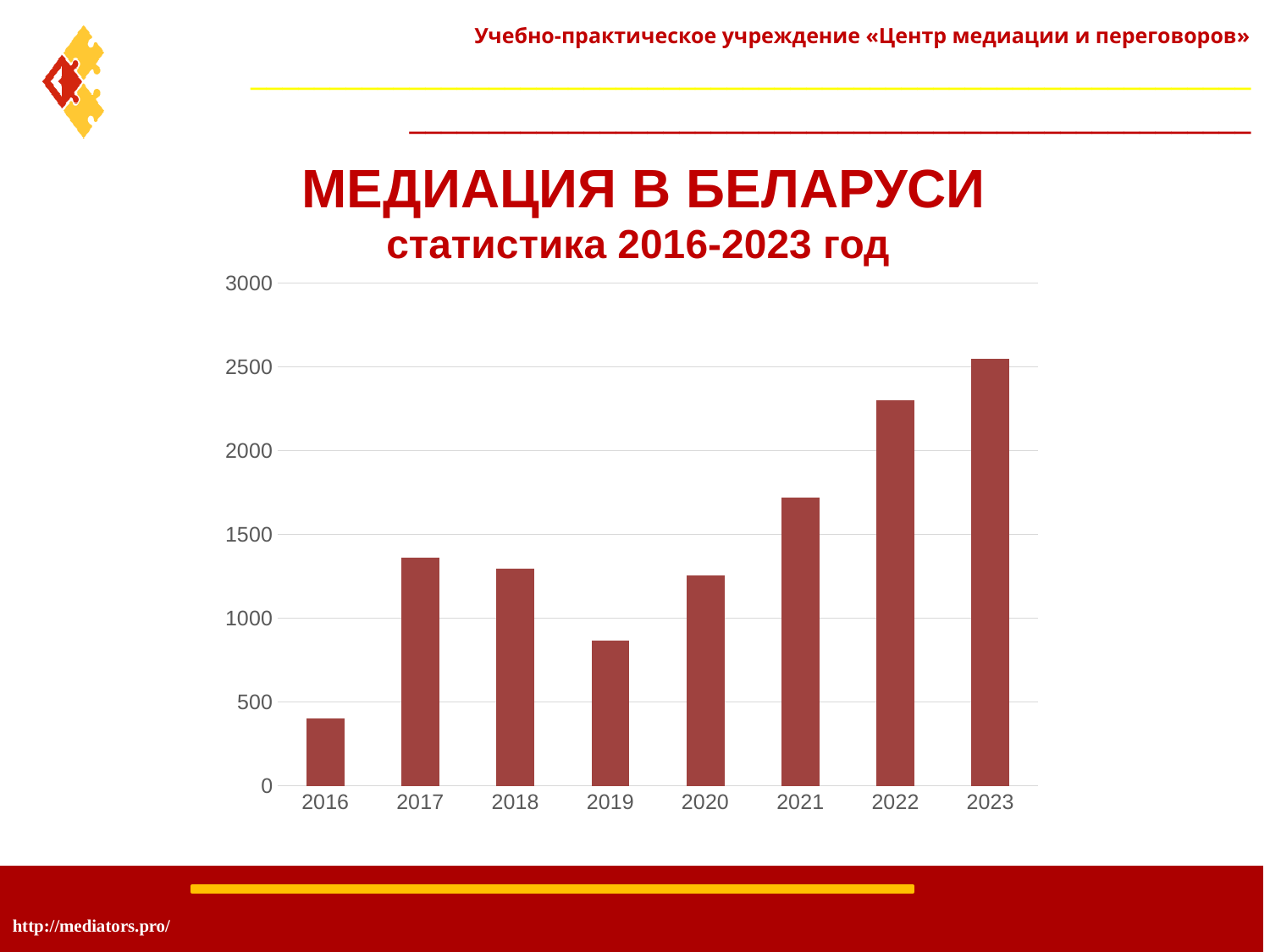
Is the value for 2022 greater or less than 2000? greater What kind of chart is shown on the slide? bar chart Which year has the highest bar in the chart? 2023 Which year has the larger value, 2019 or 2021? 2021 What is the subtitle of the chart below «МЕДИАЦИЯ В БЕЛАРУСИ»? статистика 2016-2023 год How many years are shown on the x axis of the chart? 8 Which year has the lowest bar in the chart? 2016 Is the value for 2019 greater or less than 1000? less Is the value for 2021 greater or less than 1500? greater Which year has the larger value, 2022 or 2023? 2023 Do the values generally rise or fall from 2020 to 2023? rise